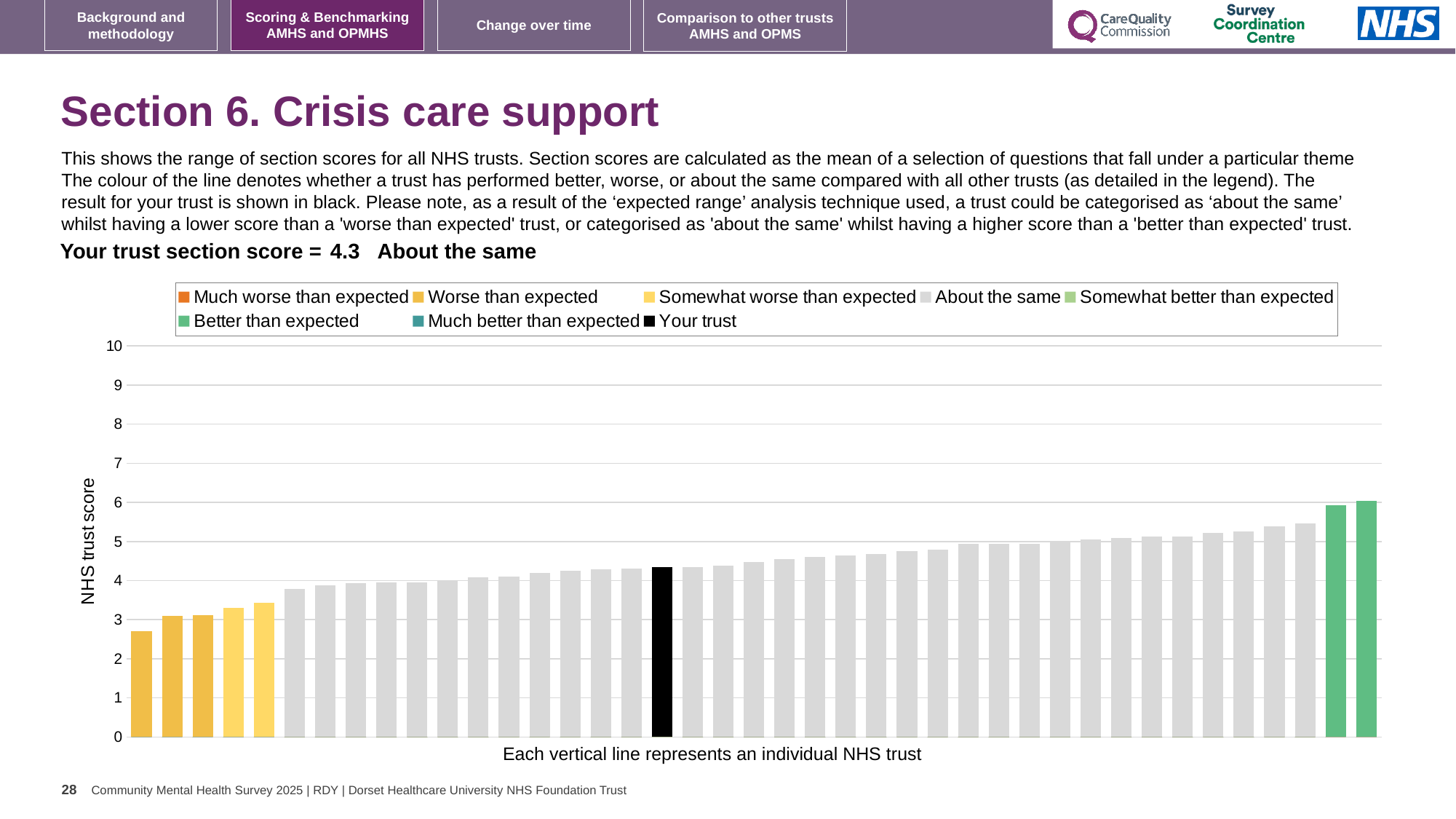
What is the label shown beneath the horizontal axis of the chart? Each vertical line represents an individual NHS trust Which category is your trust placed in for this section? About the same What is the label on the vertical axis of the chart? NHS trust score Is the value of the highest bar (the rightmost trust) greater or less than 5? greater How many bars are coloured as 'Better than expected' (green)? 2 Is the value for your trust (the black bar) greater or less than 5? less How many bars are coloured as 'Worse than expected'? 3 What kind of chart is shown on the slide? Bar chart How many entries does the chart legend list? 8 Is the value of the lowest bar (the leftmost trust) greater or less than 3? less What is the section score for your trust (the black bar)? 4.3 Do the bar values rise or fall from left to right along the x axis? rise